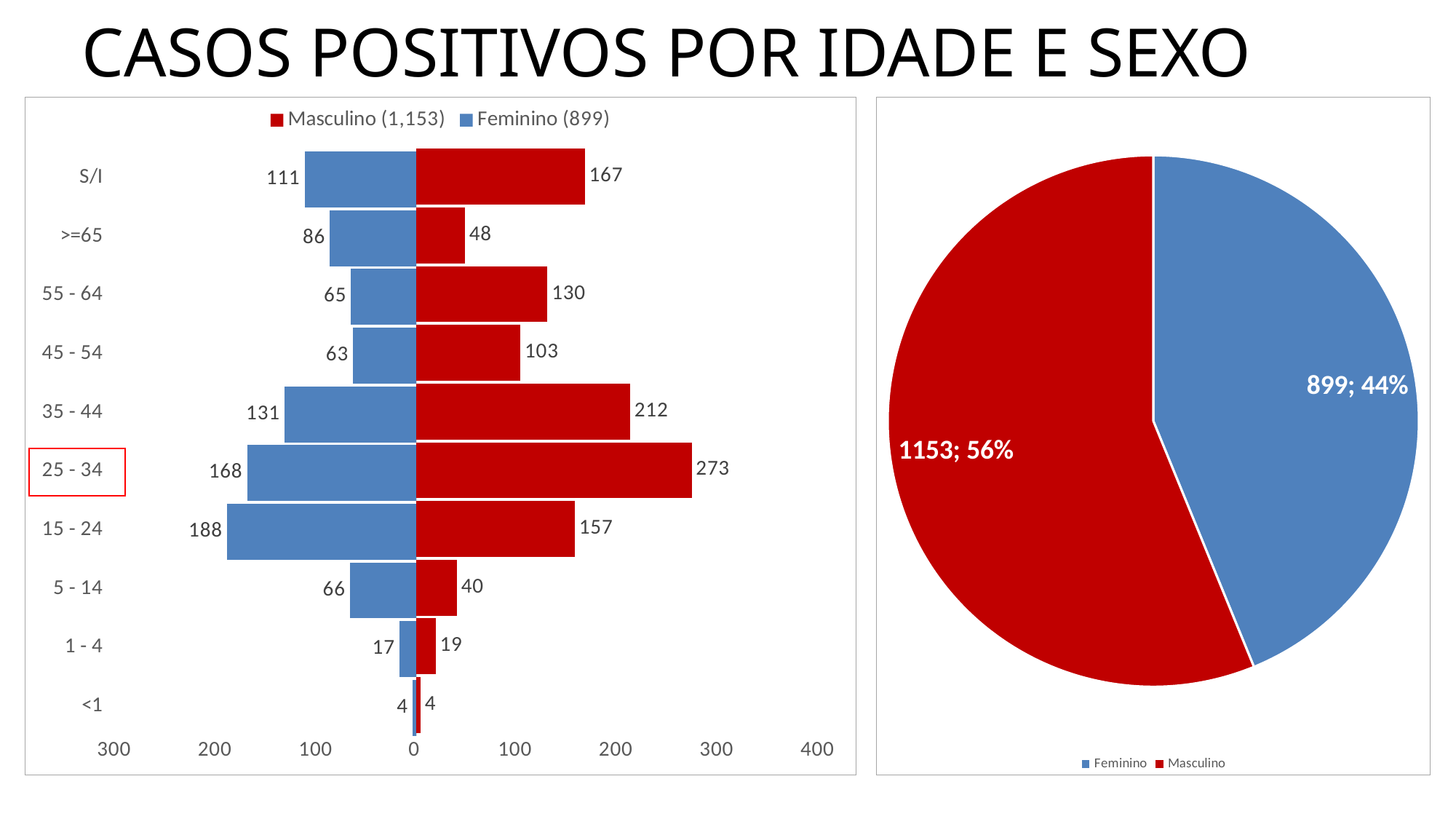
In the pie chart on the right, what is the value shown for Feminino? 899 In the pie chart on the right, what share of cases is Masculino? 56% In the bar chart on the left, which age group has the lowest Feminino value? <1 In the bar chart on the left, what is the Feminino value for the 15 - 24 age group? 188 How many age groups are shown in the bar chart on the left? 10 In the bar chart on the left, what is the Masculino value for the 25 - 34 age group? 273 What kind of chart is shown on the right side of the slide? Pie chart In the bar chart on the left, which colour represents the Feminino series? Blue In the bar chart on the left, which age group has the highest Masculino value? 25 - 34 In the bar chart on the left, what is the difference between the Masculino and Feminino values for the 35 - 44 age group? 81 How many series does the legend of the bar chart on the left list? 2 In the bar chart on the left, for the 15 - 24 age group, which is larger: the Masculino value or the Feminino value? Feminino